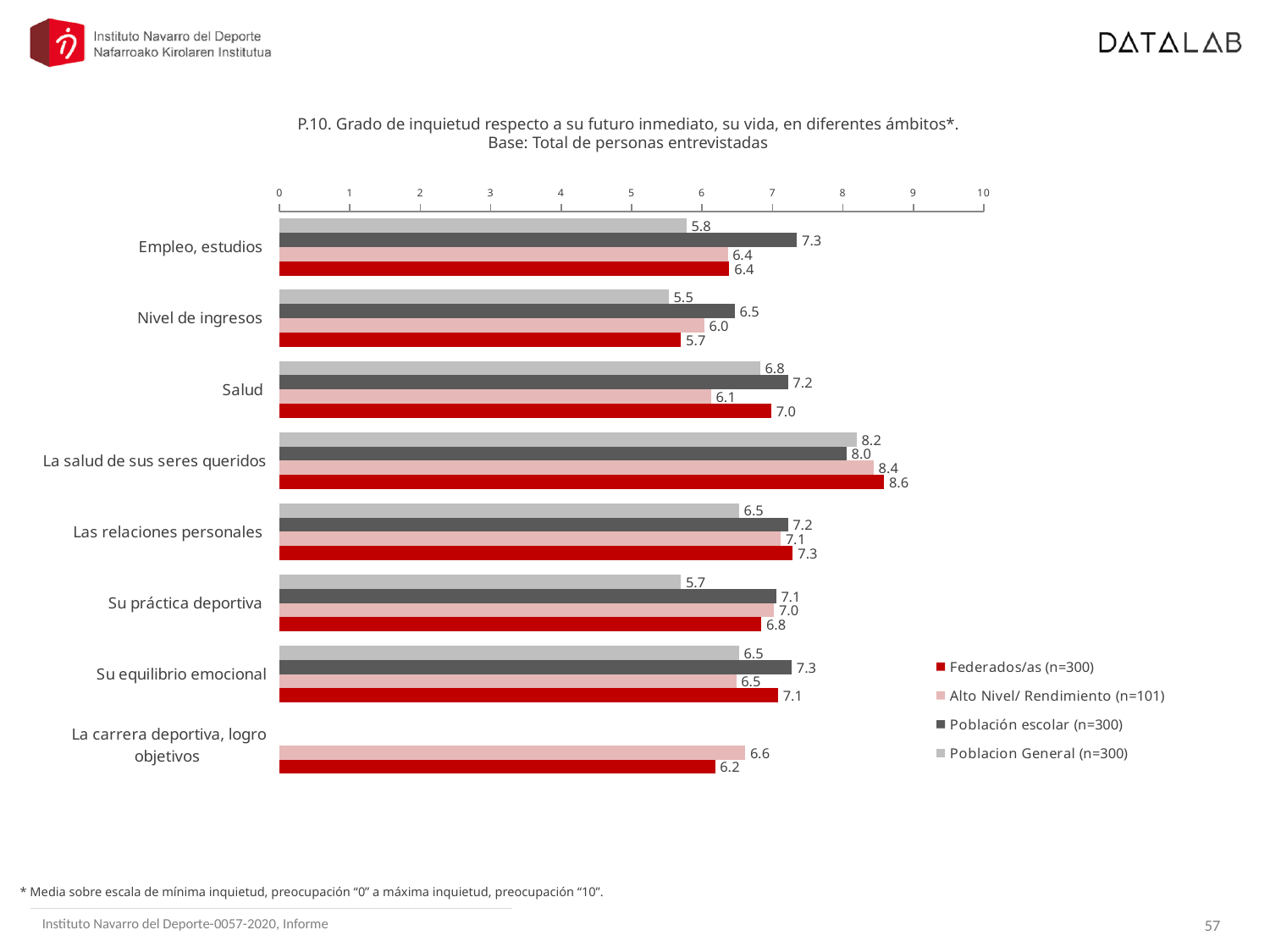
How many categories are shown on the vertical axis of the chart? 8 What colour represents the Federados/as (n=300) series in the legend? red How many series does the legend list? 4 In the category 'Empleo, estudios', what is the difference between the Población escolar (n=300) value and the Poblacion General (n=300) value? 1.5 In the category 'Salud', which series has the larger value: Federados/as (n=300) or Alto Nivel/ Rendimiento (n=101)? Federados/as (n=300) What is the value for Poblacion General (n=300) in the category 'Empleo, estudios'? 5.8 What kind of chart is shown on the slide? bar chart Which category has the lowest value for the Poblacion General (n=300) series? Nivel de ingresos Which category has the highest value for the Federados/as (n=300) series? La salud de sus seres queridos What is the value for Alto Nivel/ Rendimiento (n=101) in the category 'La carrera deportiva, logro objetivos'? 6.6 Is the value for Federados/as (n=300) in the category 'Nivel de ingresos' greater or less than 6? less What is the value for Federados/as (n=300) in the category 'La salud de sus seres queridos'? 8.6